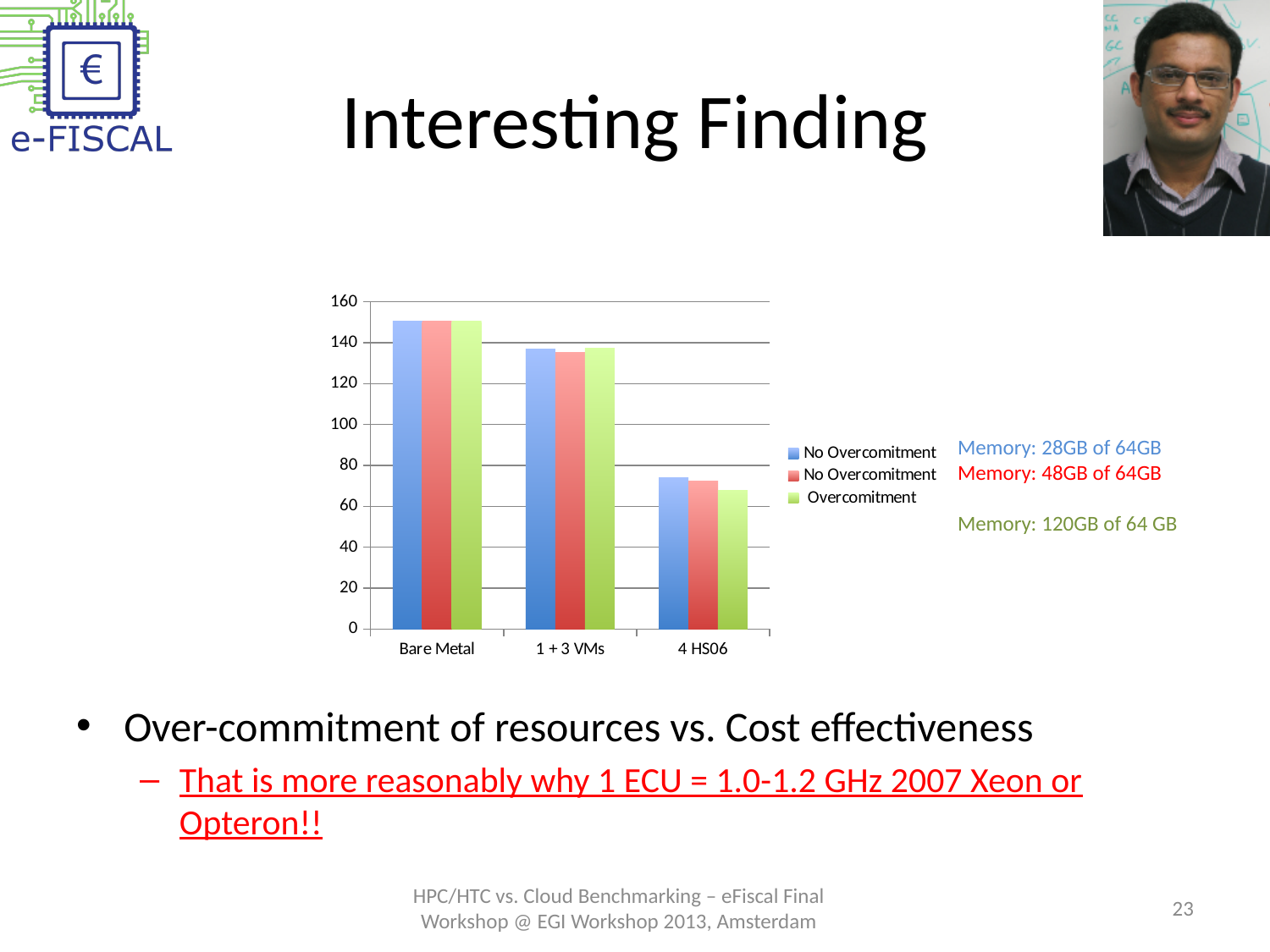
Which is larger: the value for 1 + 3 VMs or the value for 4 HS06 in the Overcomitment series? 1 + 3 VMs What kind of chart is shown on the slide? bar chart Which category has the lowest bars in the chart? 4 HS06 Is the value for Bare Metal in the first series greater or less than 140? greater Is the value for 1 + 3 VMs in the first series greater or less than 120? greater How many categories are shown on the x axis of the chart? 3 Is the value for 4 HS06 in the first series greater or less than 60? greater Do the values rise or fall moving from Bare Metal to 4 HS06 along the x axis? fall Which category has the highest bars in the chart? Bare Metal How many series does the chart's legend list? 3 What is the label of the third category on the x axis of the chart? 4 HS06